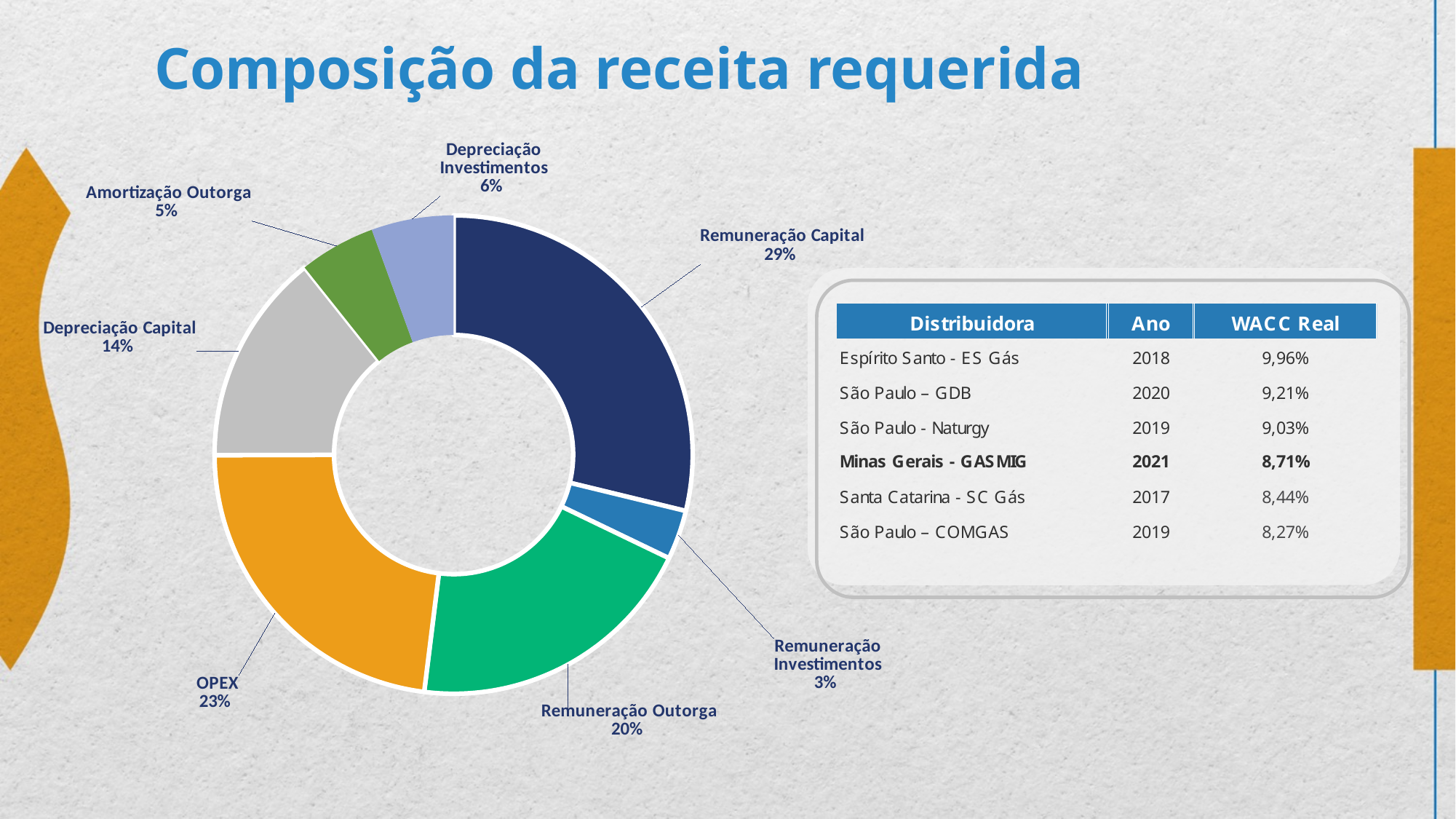
What is the title of the slide containing the pie chart? Composição da receita requerida What percentage is shown for OPEX in the pie chart? 23% Which is larger, Depreciação Investimentos or Amortização Outorga? Depreciação Investimentos Which slice of the pie chart is the largest? Remuneração Capital What share of the required revenue does Remuneração Capital represent in the pie chart? 29% What percentage is shown for Remuneração Investimentos? 3% What is the combined share of Remuneração Capital and Remuneração Outorga? 49% What kind of chart is shown on the slide? pie chart (donut) Which slice of the pie chart is the smallest? Remuneração Investimentos How many slices does the pie chart have? 7 What is the difference in percentage points between OPEX and Remuneração Outorga? 3 What percentage is shown for Depreciação Capital? 14%